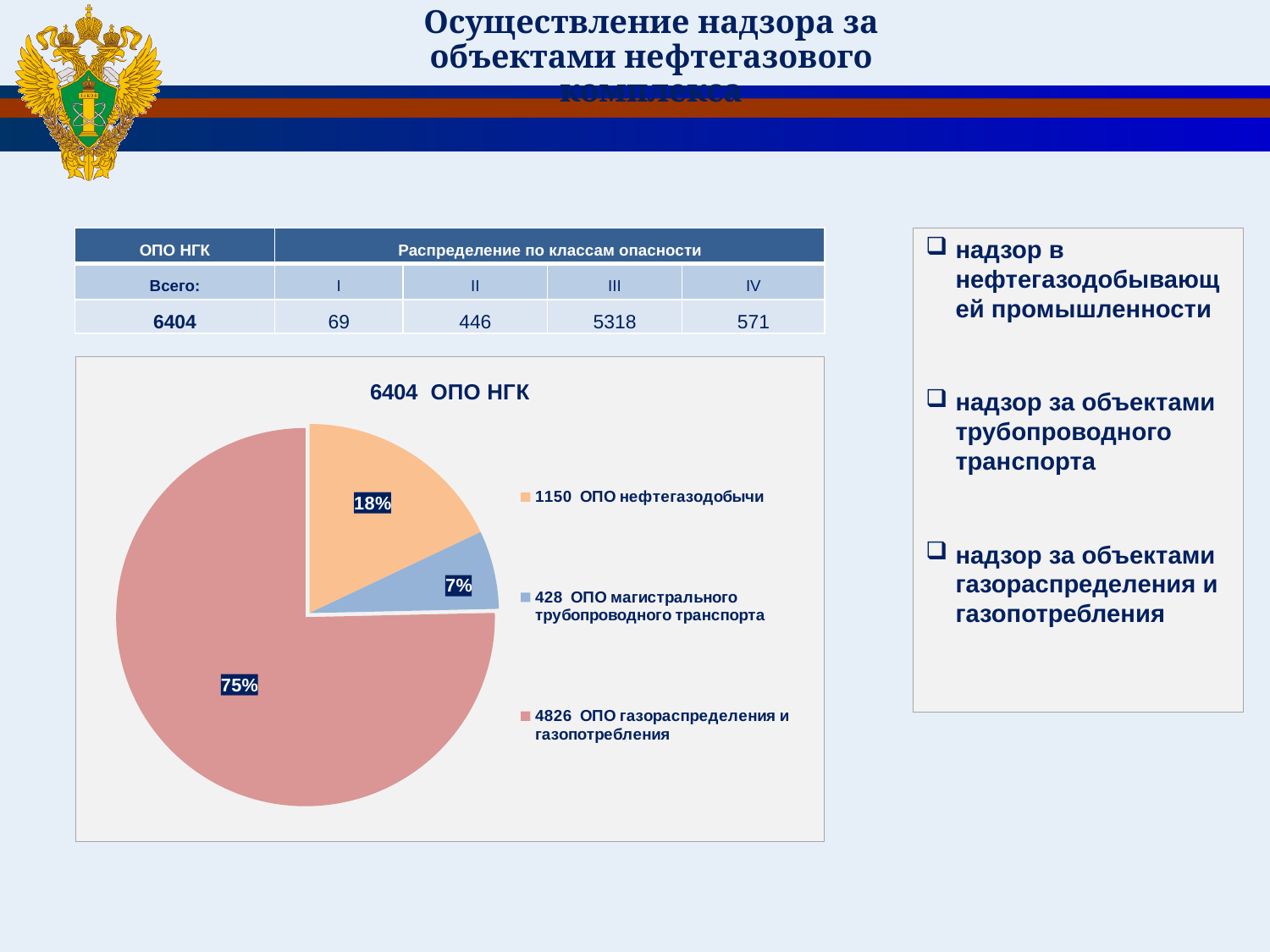
What is the title of the pie chart? 6404 ОПО НГК What share of the pie does the slice for ОПО магистрального трубопроводного транспорта represent? 7% Which is larger: the share for ОПО нефтегазодобычи or the share for ОПО магистрального трубопроводного транспорта? ОПО нефтегазодобычи According to the legend, how many ОПО нефтегазодобычи are there? 1150 What share of the pie does the slice for ОПО газораспределения и газопотребления represent? 75% How many slices does the pie chart have? 3 What share of the pie does the slice for ОПО нефтегазодобычи represent? 18% According to the legend, how many ОПО магистрального трубопроводного транспорта are there? 428 What kind of chart is shown on the slide? pie chart Which category has the smallest slice in the pie chart? ОПО магистрального трубопроводного транспорта What is the difference in percentage points between the share for ОПО газораспределения и газопотребления and the share for ОПО нефтегазодобычи? 57% Which category has the largest slice in the pie chart? ОПО газораспределения и газопотребления